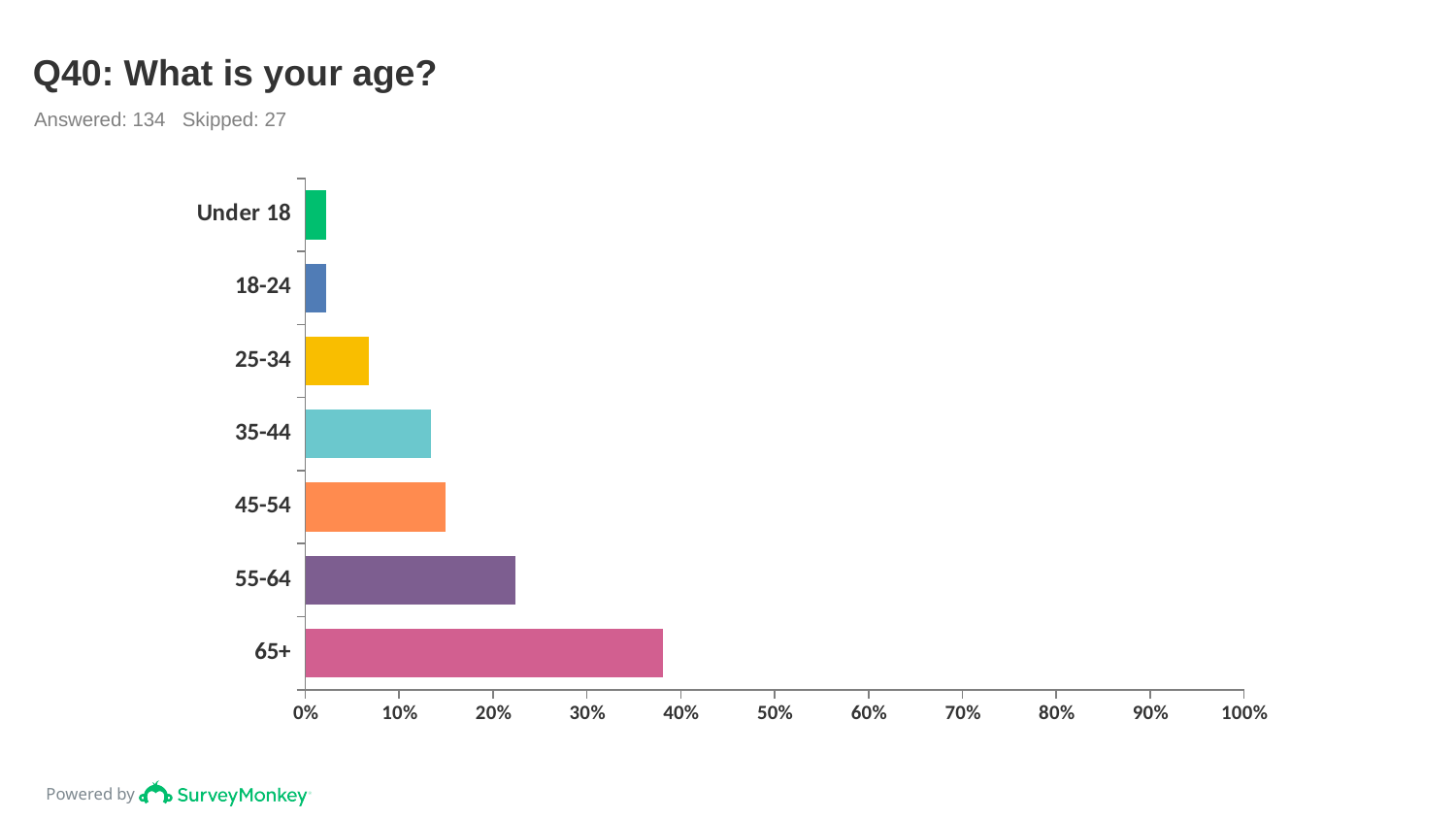
What kind of chart is shown on the slide? bar chart Which is larger, the value for 25-34 or the value for 35-44? 35-44 Is the value for 65+ greater or less than 30%? greater How many respondents answered this question according to the slide? 134 Which is larger, the value for 55-64 or the value for 45-54? 55-64 What is the title of the chart? Q40: What is your age? How many age categories are plotted in the chart? 7 Is the value for 25-34 greater or less than 10%? less Is the value for 35-44 greater or less than 10%? greater Which age category has the highest value? 65+